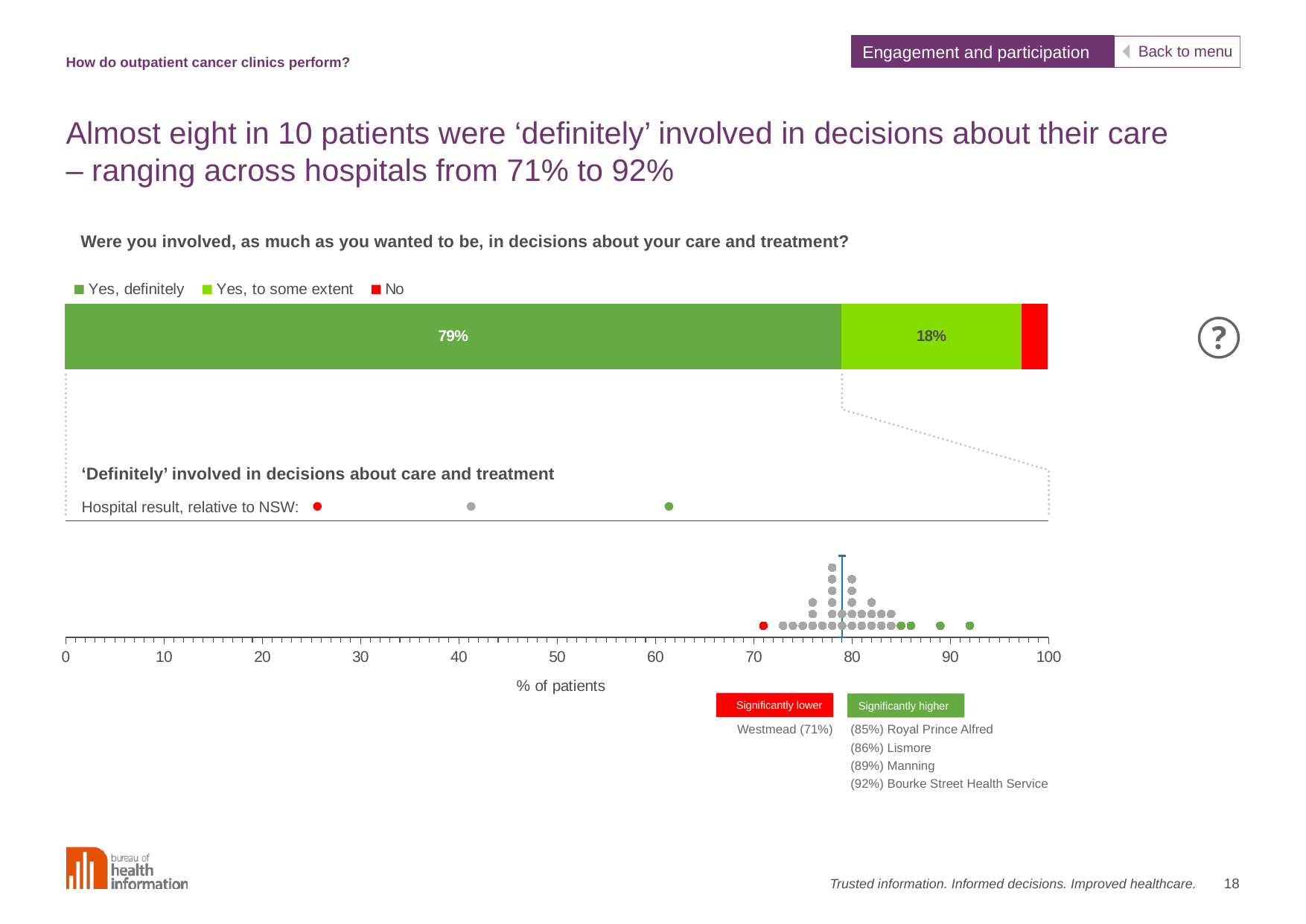
In the hospital dot plot, how many hospitals are listed as significantly higher than NSW? 4 What is the label on the x axis of the hospital dot plot? % of patients In the hospital dot plot, what is the result for Westmead? 71% What kind of chart shows the overall NSW responses at the top of the slide? Stacked bar chart In the hospital dot plot, which hospital has the lowest percentage of patients 'definitely' involved in decisions? Westmead How many response categories does the legend of the stacked bar chart list? 3 In the stacked bar chart, what percentage of patients answered 'Yes, definitely'? 79% In the hospital dot plot, which hospital has the highest percentage of patients 'definitely' involved in decisions? Bourke Street Health Service In the hospital dot plot, what is the result for Bourke Street Health Service? 92% In the stacked bar chart, which response is larger: 'Yes, definitely' or 'No'? Yes, definitely In the stacked bar chart, how many percentage points higher is 'Yes, definitely' than 'Yes, to some extent'? 61 percentage points In the stacked bar chart, what percentage of patients answered 'Yes, to some extent'? 18%